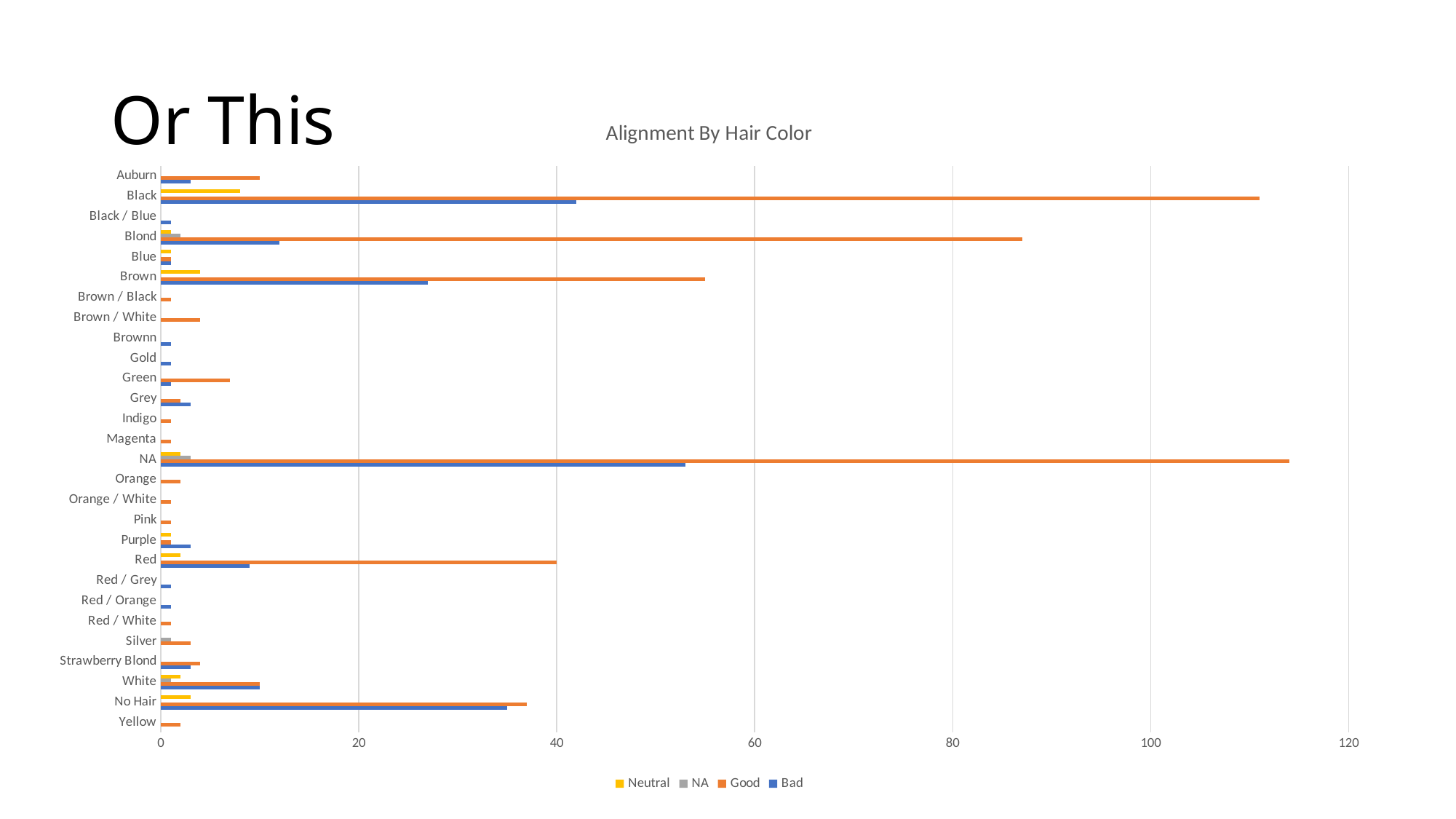
Is the Good value for Brown greater or less than 60? less Is the Bad value for NA greater or less than 40? greater What is the title of the chart? Alignment By Hair Color How many series does the legend list? 4 How many hair color categories are shown on the chart? 28 Is the Good value for White greater or less than 20? less Which is larger, the Bad value for Black or the Bad value for Brown? Black What kind of chart is shown on the slide? bar chart Which hair color has the highest Bad value? NA Which is larger, the Good value for Blond or the Good value for Brown? Blond